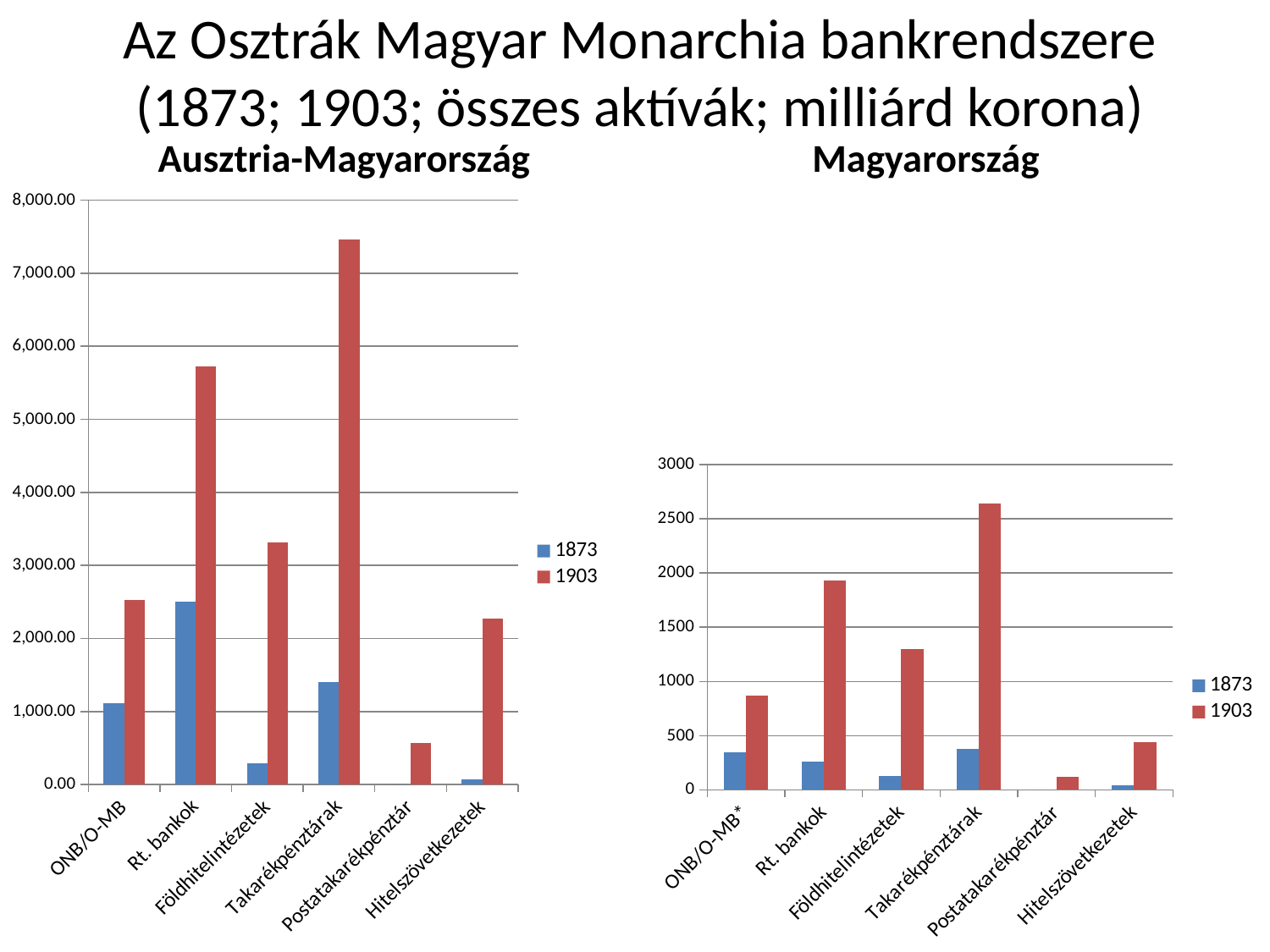
On the Ausztria-Magyarország chart, what kind of chart is shown? bar chart On the Ausztria-Magyarország chart, which category has the highest value for 1873? Rt. bankok On the Ausztria-Magyarország chart, which is larger for 1873: Rt. bankok or Takarékpénztárak? Rt. bankok On the Ausztria-Magyarország chart, how many series does the legend list? 2 On the Magyarország chart, how many categories are shown on the x axis? 6 On the Magyarország chart, which category has the lowest value for 1903? Postatakarékpénztár On the Magyarország chart, is the 1903 value for Rt. bankok greater or less than 1500? greater On the Ausztria-Magyarország chart, is the 1903 value for Rt. bankok greater or less than 5,000.00? greater On the Magyarország chart, what are the two entries in the legend? 1873 and 1903 On the Magyarország chart, which category has the highest value for 1903? Takarékpénztárak On the Ausztria-Magyarország chart, is the 1903 value for Földhitelintézetek greater or less than 4,000.00? less On the Ausztria-Magyarország chart, which category has the highest value for 1903? Takarékpénztárak